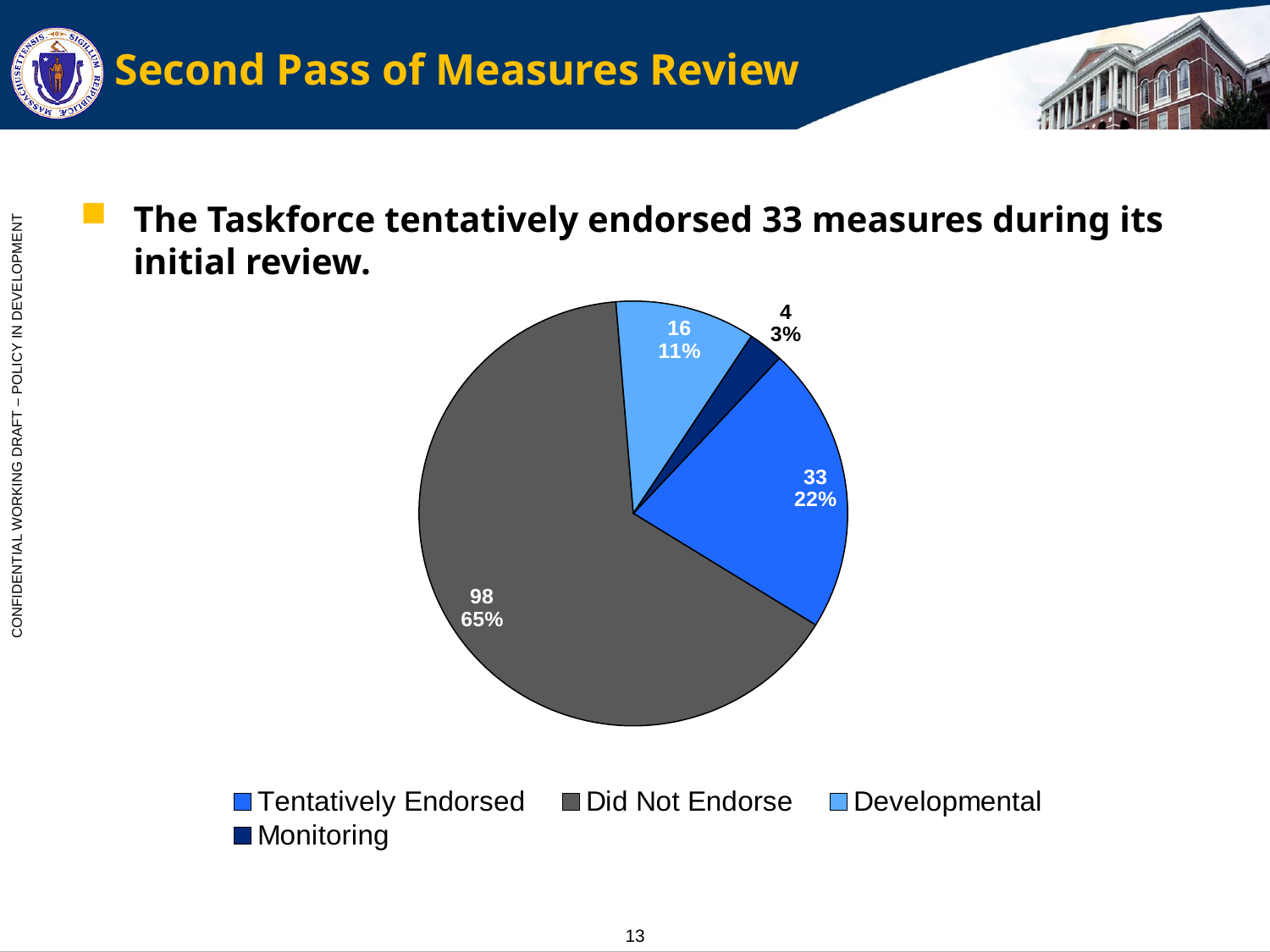
What is the difference between the number of Did Not Endorse measures and Tentatively Endorsed measures? 65 What kind of chart is shown on the slide? pie chart How many categories does the legend list? 4 Which category has the smallest slice of the pie? Monitoring How many measures are Developmental? 16 Which is larger, the Developmental slice or the Monitoring slice? Developmental How many measures are in the Monitoring category? 4 Which category has the largest slice of the pie? Did Not Endorse How many measures fall under Did Not Endorse? 98 What share of the pie does Did Not Endorse represent? 65% What share of the pie does Developmental represent? 11% How many measures were Tentatively Endorsed? 33